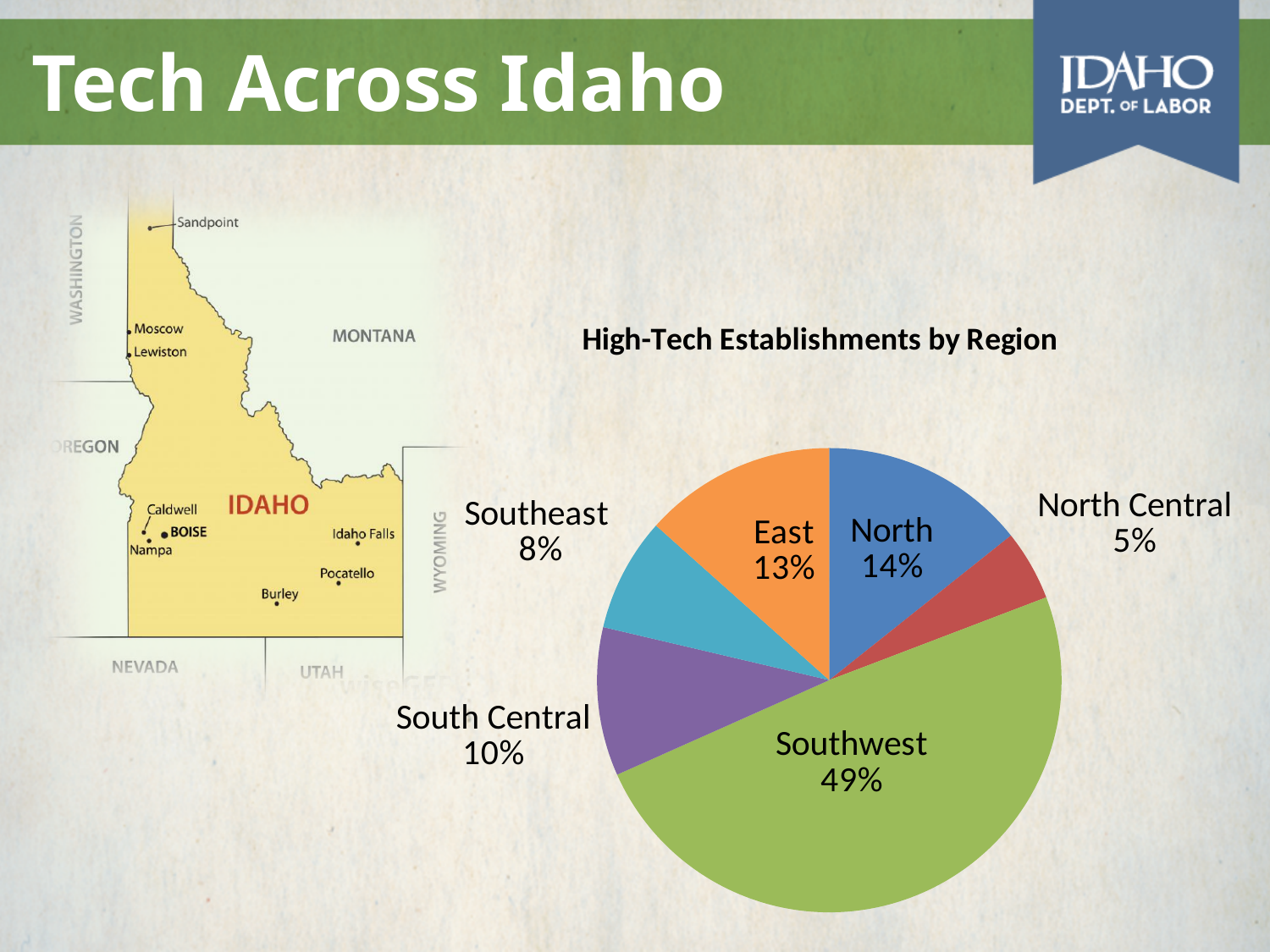
What type of chart is used to show high-tech establishments by region? Pie chart Which region has a larger share, South Central or Southeast? South Central What is the title of the pie chart? High-Tech Establishments by Region Which region has the smallest share of high-tech establishments? North Central What is the difference in percentage points between the Southwest and North regions? 35 What colour is the Southwest slice of the pie chart? Green What share of high-tech establishments is in the Southwest region? 49% How many regions are shown in the pie chart? 6 What percentage of high-tech establishments is in the East region? 13% What percentage of high-tech establishments is in the North region? 14% Which region has the largest share of high-tech establishments? Southwest What percentage of high-tech establishments is in the North Central region? 5%